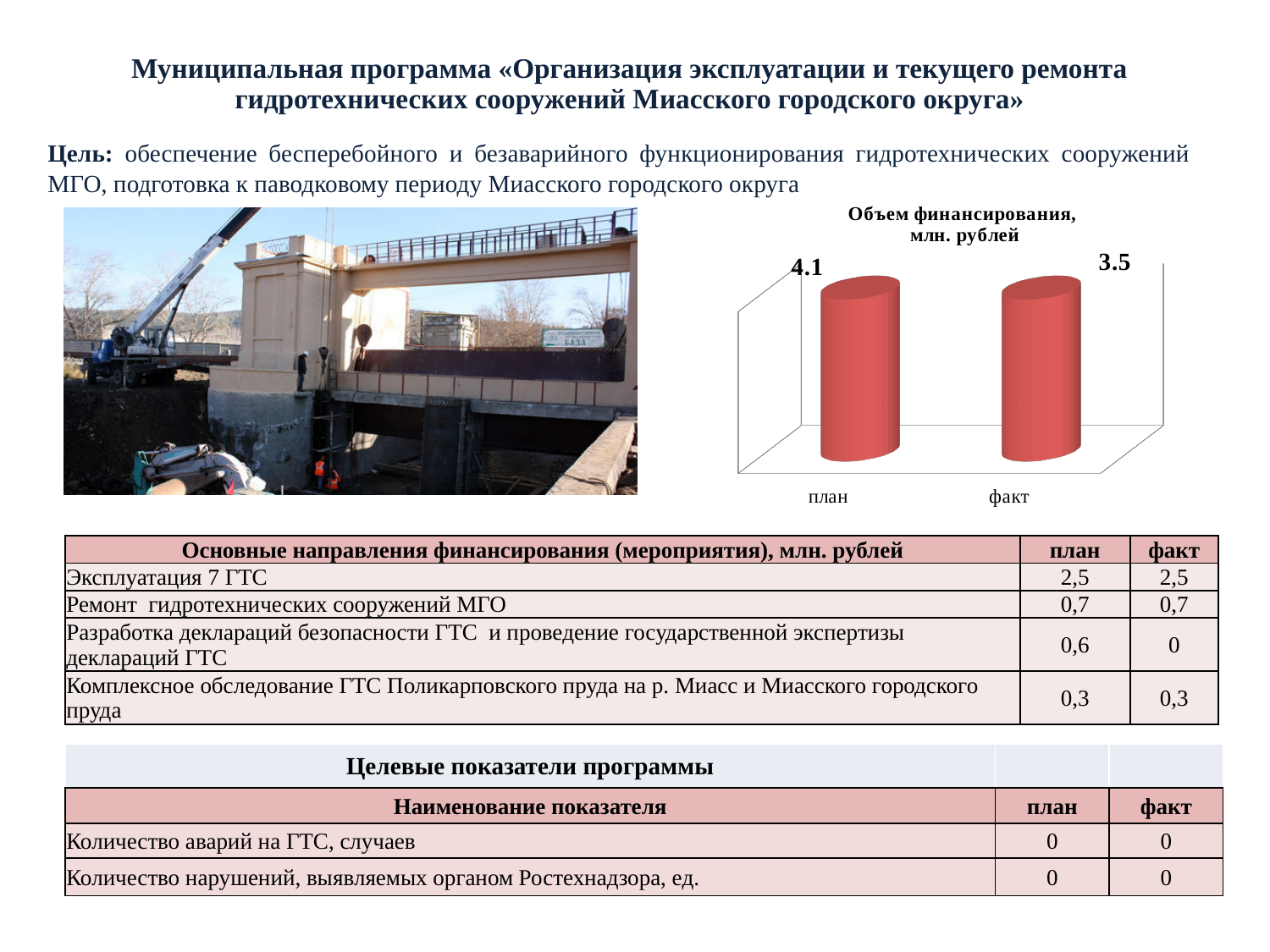
What is the title of the chart on the slide? Объем финансирования, млн. рублей What is the value for план in the chart "Объем финансирования, млн. рублей"? 4.1 Which category has the lowest value in the chart "Объем финансирования, млн. рублей"? факт How many bars are shown in the chart "Объем финансирования, млн. рублей"? 2 What is the difference between the план and факт values in the chart "Объем финансирования, млн. рублей"? 0.6 What kind of chart is "Объем финансирования, млн. рублей"? bar chart What is the value for факт in the chart "Объем финансирования, млн. рублей"? 3.5 Do the values rise or fall from план to факт in the chart "Объем финансирования, млн. рублей"? fall In the chart "Объем финансирования, млн. рублей", which is larger: план or факт? план Which category has the highest value in the chart "Объем финансирования, млн. рублей"? план What colour are the bars in the chart "Объем финансирования, млн. рублей"? red